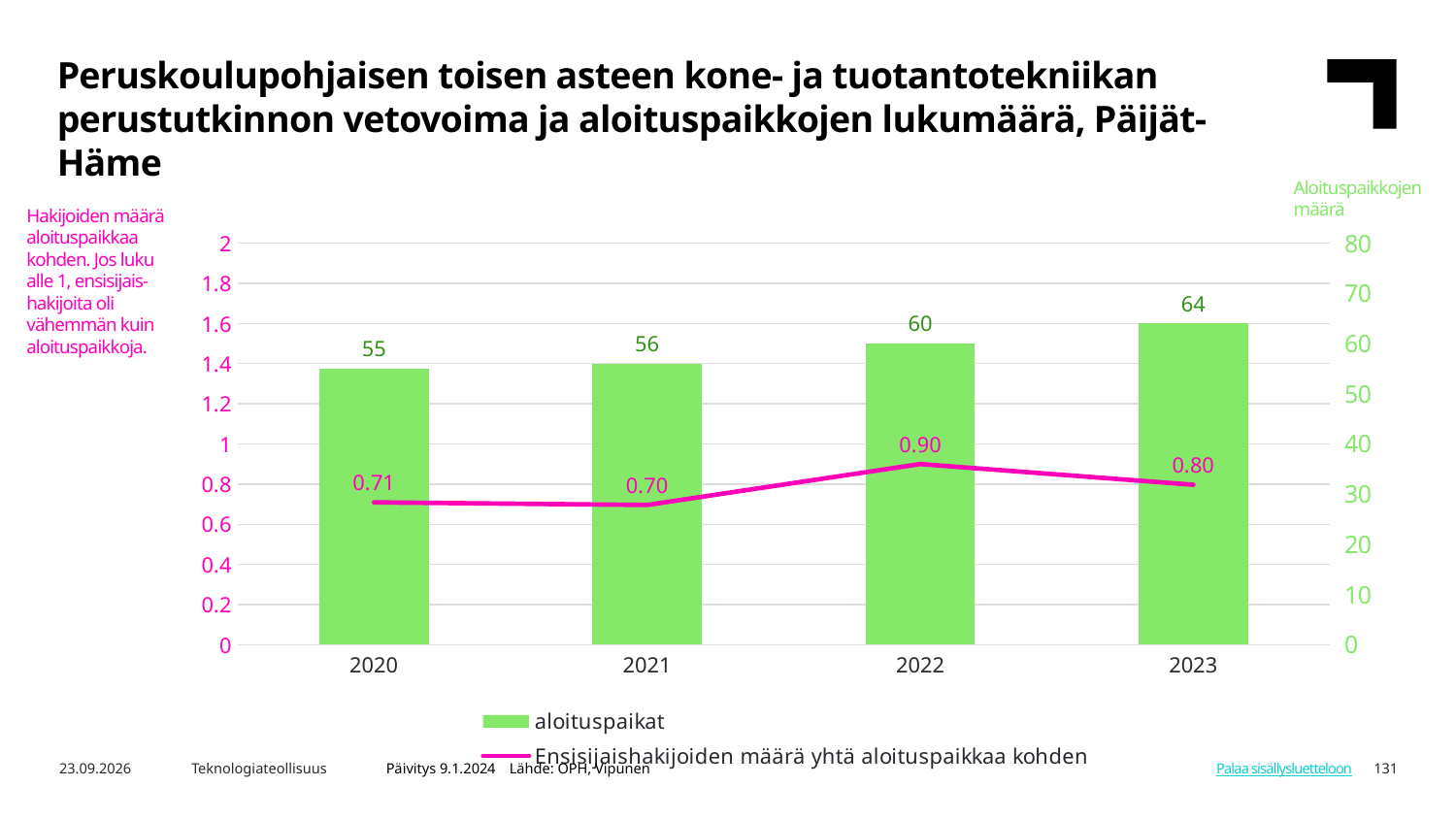
What is the value of Ensisijaishakijoiden määrä yhtä aloituspaikkaa kohden for 2021? 0.70 How many years are shown on the x axis? 4 How many series does the legend list? 2 Which year has a higher value of Ensisijaishakijoiden määrä yhtä aloituspaikkaa kohden, 2022 or 2023? 2022 Which year has the highest value of aloituspaikat? 2023 Do the aloituspaikat values rise or fall from 2020 to 2023? rise What is the difference in aloituspaikat between 2023 and 2020? 9 Which year has the lowest value of Ensisijaishakijoiden määrä yhtä aloituspaikkaa kohden? 2021 What is the value of aloituspaikat for 2022? 60 What is the value of aloituspaikat for 2020? 55 Is the value of aloituspaikat for 2021 greater or less than 50? greater What colour are the aloituspaikat bars? green